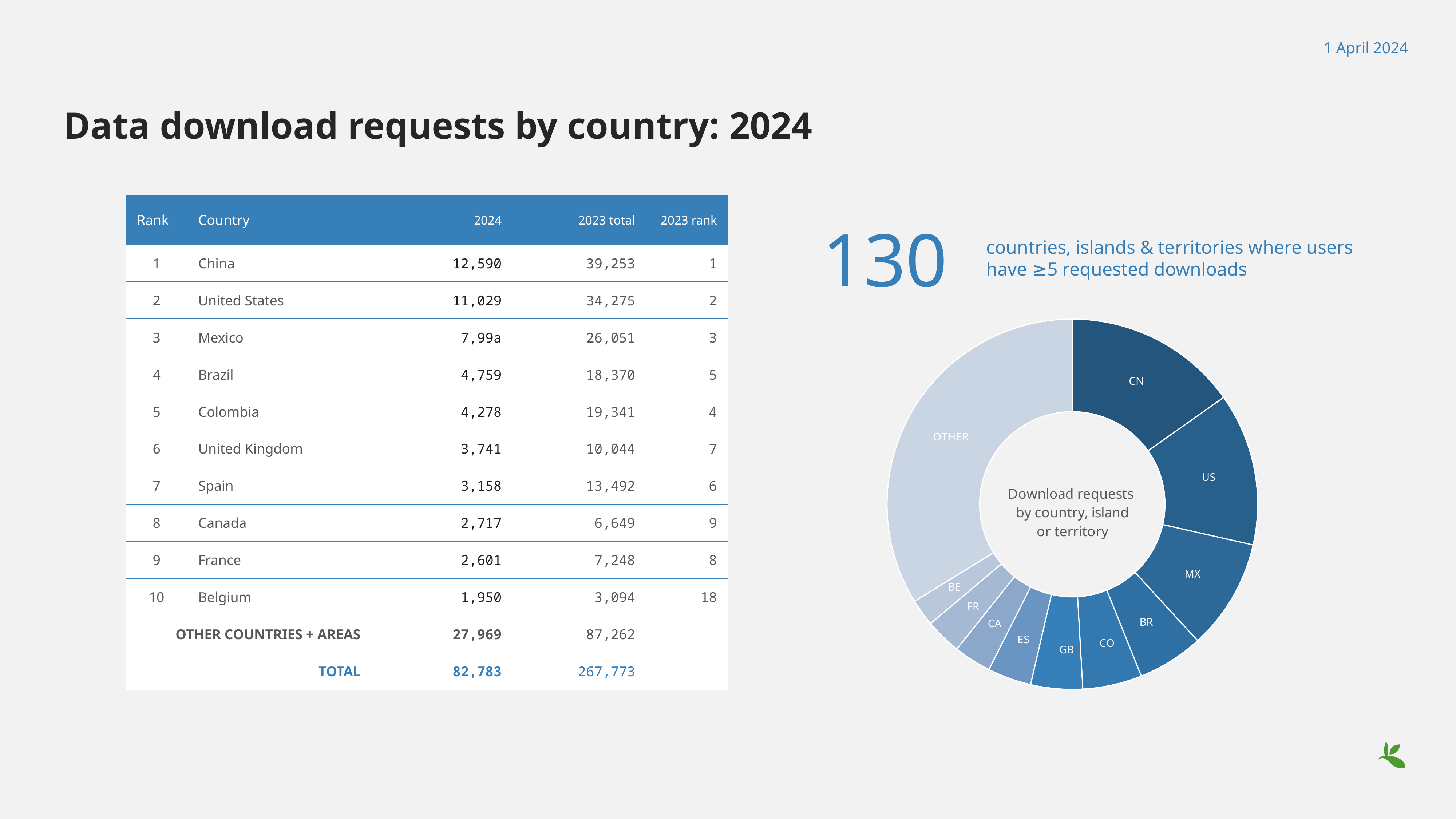
What text is written in the centre of the donut chart? Download requests by country, island or territory In the donut chart, is the US slice larger or smaller than the MX slice? Larger What is the difference between the 2024 download requests for China and the United States? 1,561 In the donut chart, which slice is larger, CN or US? CN How many slices does the donut chart have? 11 Excluding the OTHER slice, which country has the largest slice in the donut chart? CN According to the slide, how many download requests did the United Kingdom (GB) make in 2024? 3,741 What large number is shown above the donut chart? 130 What kind of chart is shown on the right of the slide? Donut (pie) chart According to the slide, how many download requests did China (CN) make in 2024? 12,590 Which labelled slice of the donut chart is the smallest? BE Which slice of the donut chart is the largest? OTHER